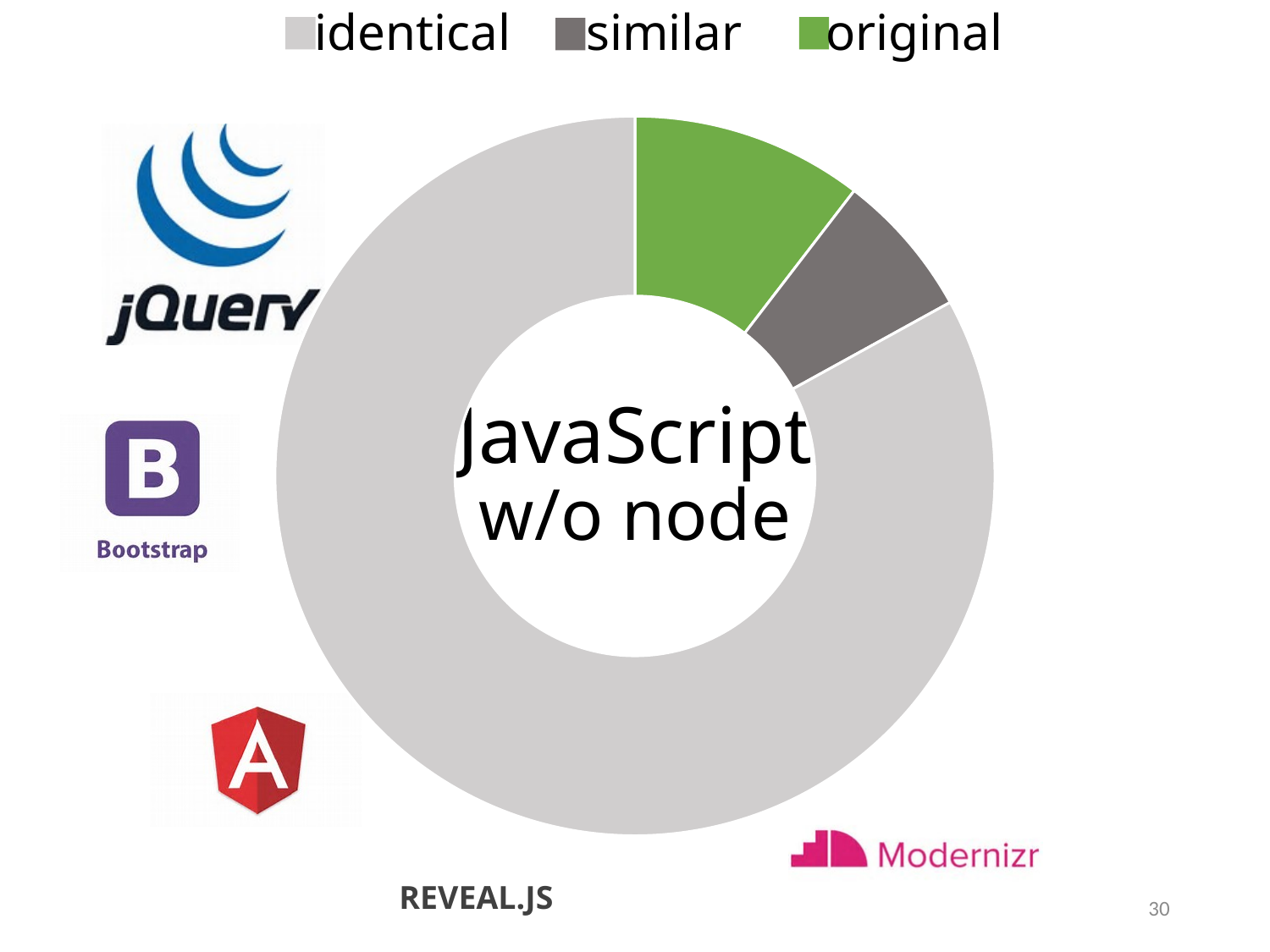
Which colour represents the original category in the legend? Green Which is larger, the share for identical or the share for original? identical What text is shown in the centre of the doughnut chart? JavaScript w/o node Which category takes up the largest share of the chart? identical Which category takes up the smallest share of the chart? similar How many entries does the legend list? 3 Which is larger, the share for original or the share for similar? original What kind of chart is shown on the slide? Doughnut chart How many categories does the chart divide the ring into? 3